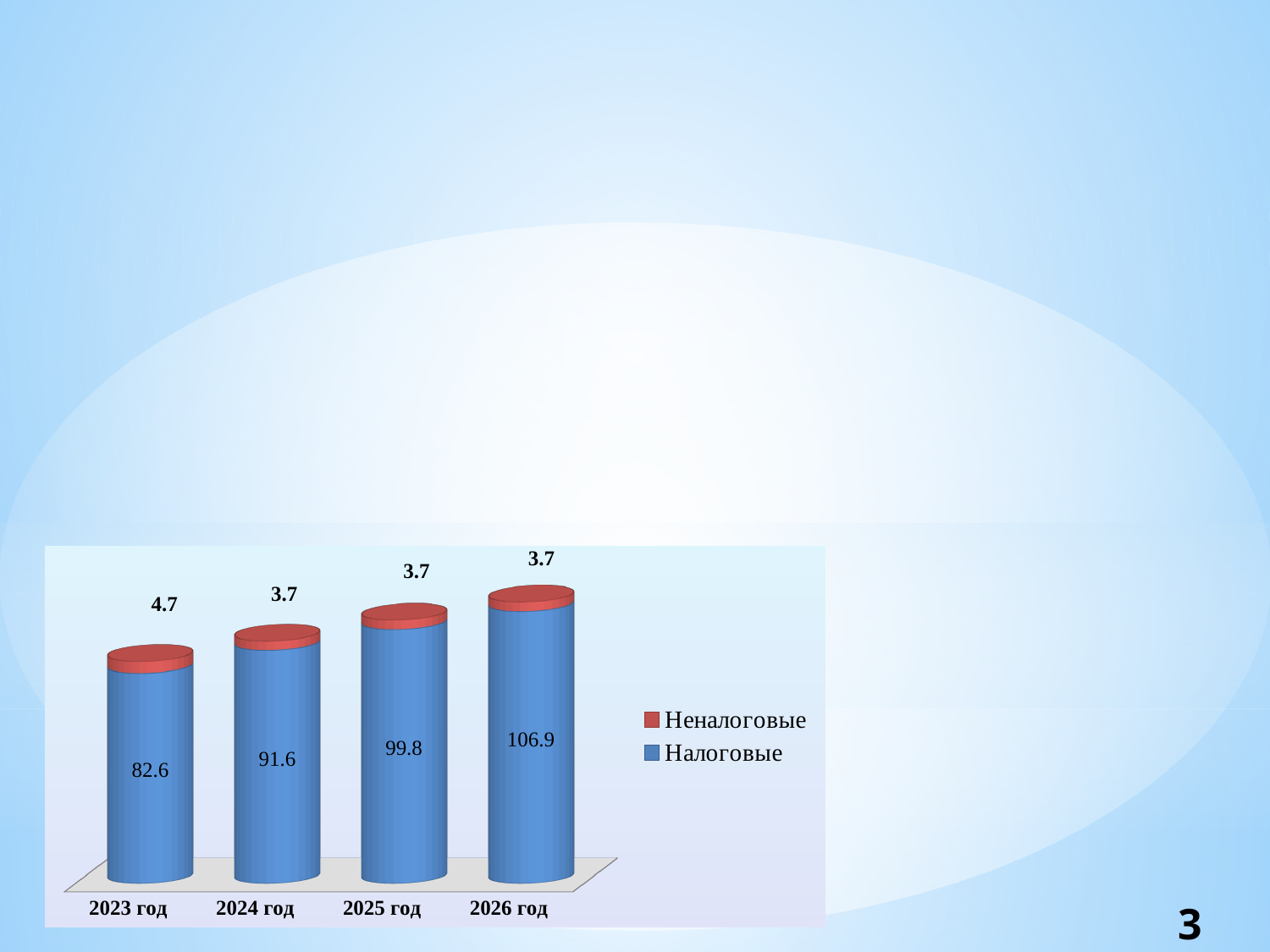
Which is larger, the Налоговые value for 2024 год or for 2025 год? 2025 год What is the value of Неналоговые for 2025 год? 3.7 Which year has the lowest value for Налоговые? 2023 год What kind of chart is shown on the slide? Stacked bar chart What is the value of Налоговые for 2026 год? 106.9 Which year has the highest value for Налоговые? 2026 год What is the value of Налоговые for 2023 год? 82.6 What is the value of Неналоговые for 2023 год? 4.7 What is the total of the stacked bar for 2024 год? 95.3 How many series does the legend list? 2 What is the difference between the Налоговые values for 2026 год and 2023 год? 24.3 How many years are shown on the x axis? 4